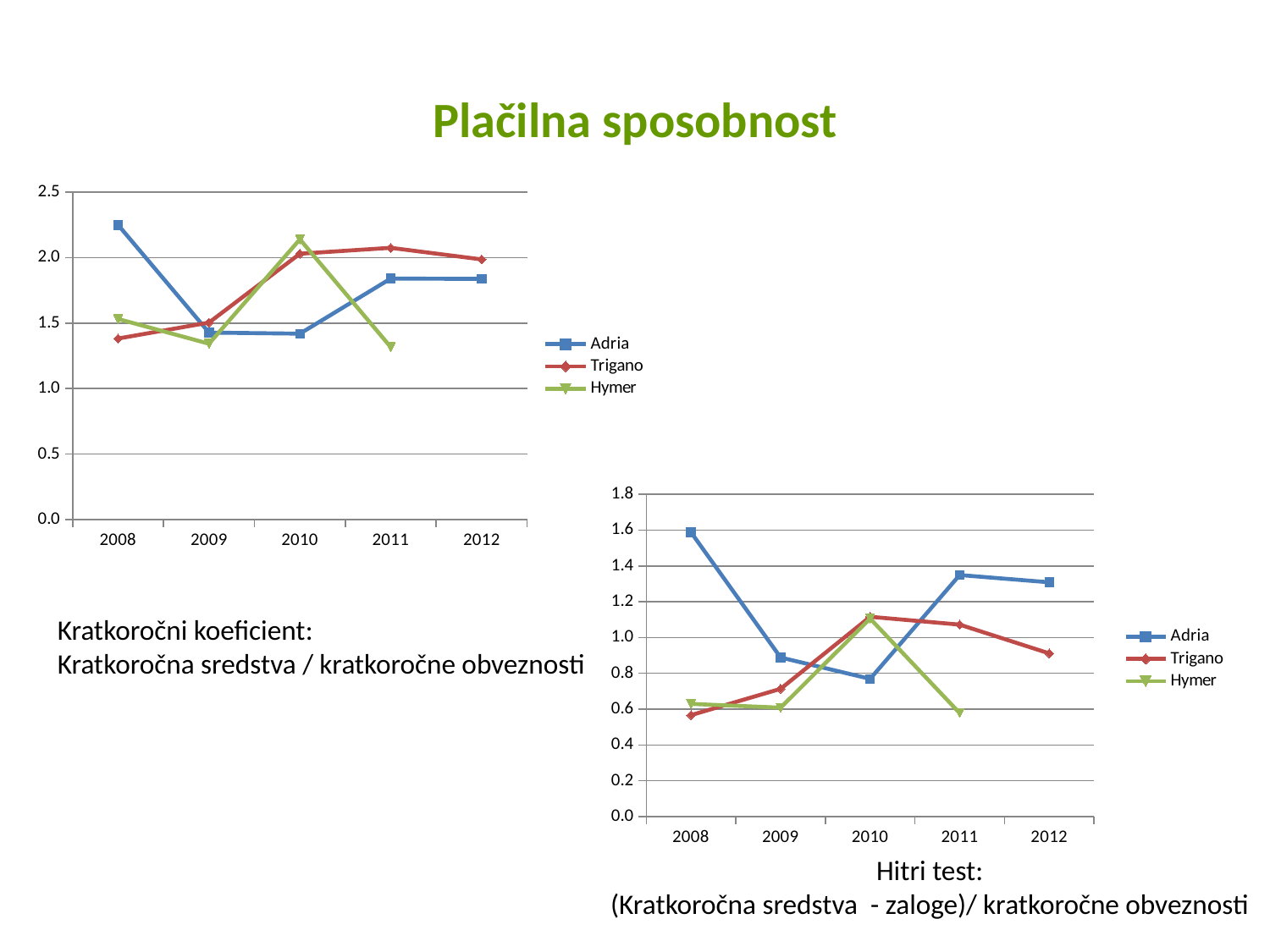
How many series does the legend of the bottom-right chart (Hitri test) list? 3 In the bottom-right chart (Hitri test), which series has the lowest value in 2008? Trigano In the bottom-right chart (Hitri test), does the Adria line rise or fall from 2008 to 2010? fall In the top-left chart (Kratkoročni koeficient), in which year does Adria reach its highest value? 2008 How many years are shown on the x axis of the top-left chart (Kratkoročni koeficient)? 5 In the bottom-right chart (Hitri test), is the value for Adria in 2010 greater or less than 1.0? less In the top-left chart (Kratkoročni koeficient), which series has no data point for 2012? Hymer What is the title of the slide? Plačilna sposobnost In the top-left chart (Kratkoročni koeficient), is the value for Adria in 2008 greater or less than 2.0? greater In the top-left chart (Kratkoročni koeficient), which series has the highest value in 2010? Hymer What kind of chart is the top-left chart (Kratkoročni koeficient)? line chart In the bottom-right chart (Hitri test), which is larger in 2012: Adria or Trigano? Adria